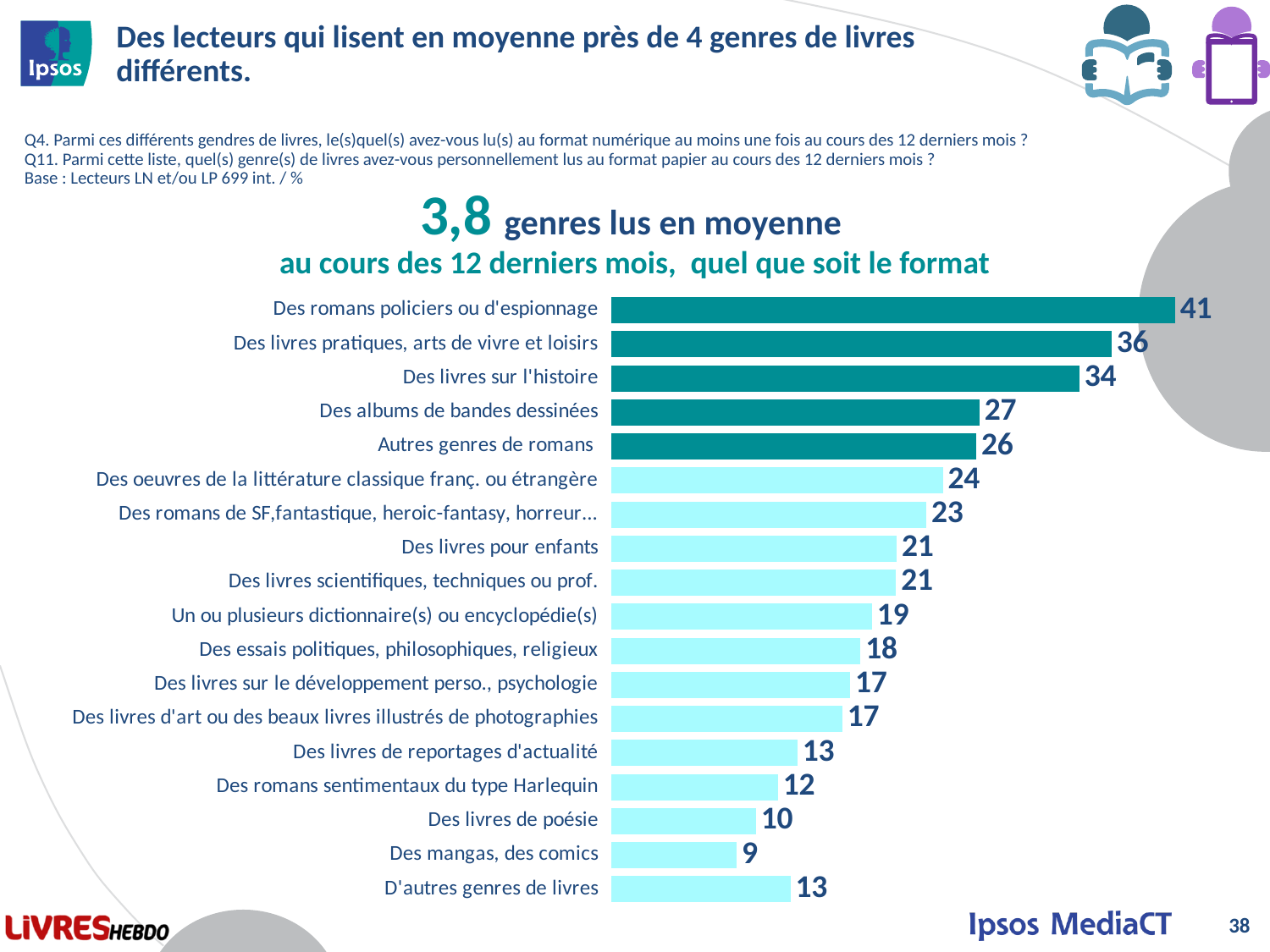
What kind of chart is shown on the slide? Bar chart What average number of genres read is highlighted above the chart? 3,8 What is the value for "Des livres de poésie"? 10 Which category has the highest value? Des romans policiers ou d'espionnage Which category has the lowest value? Des mangas, des comics What is the difference between the values for "Des livres pratiques, arts de vivre et loisirs" and "Des albums de bandes dessinées"? 9 What is the value for "Des mangas, des comics"? 9 How many categories are shown in the chart? 18 What is the value for "Des livres sur l'histoire"? 34 Which is larger, the value for "Des livres pour enfants" or the value for "Des essais politiques, philosophiques, religieux"? Des livres pour enfants What is the value for "Des romans policiers ou d'espionnage"? 41 What is the difference between the values for "Des romans policiers ou d'espionnage" and "Des mangas, des comics"? 32